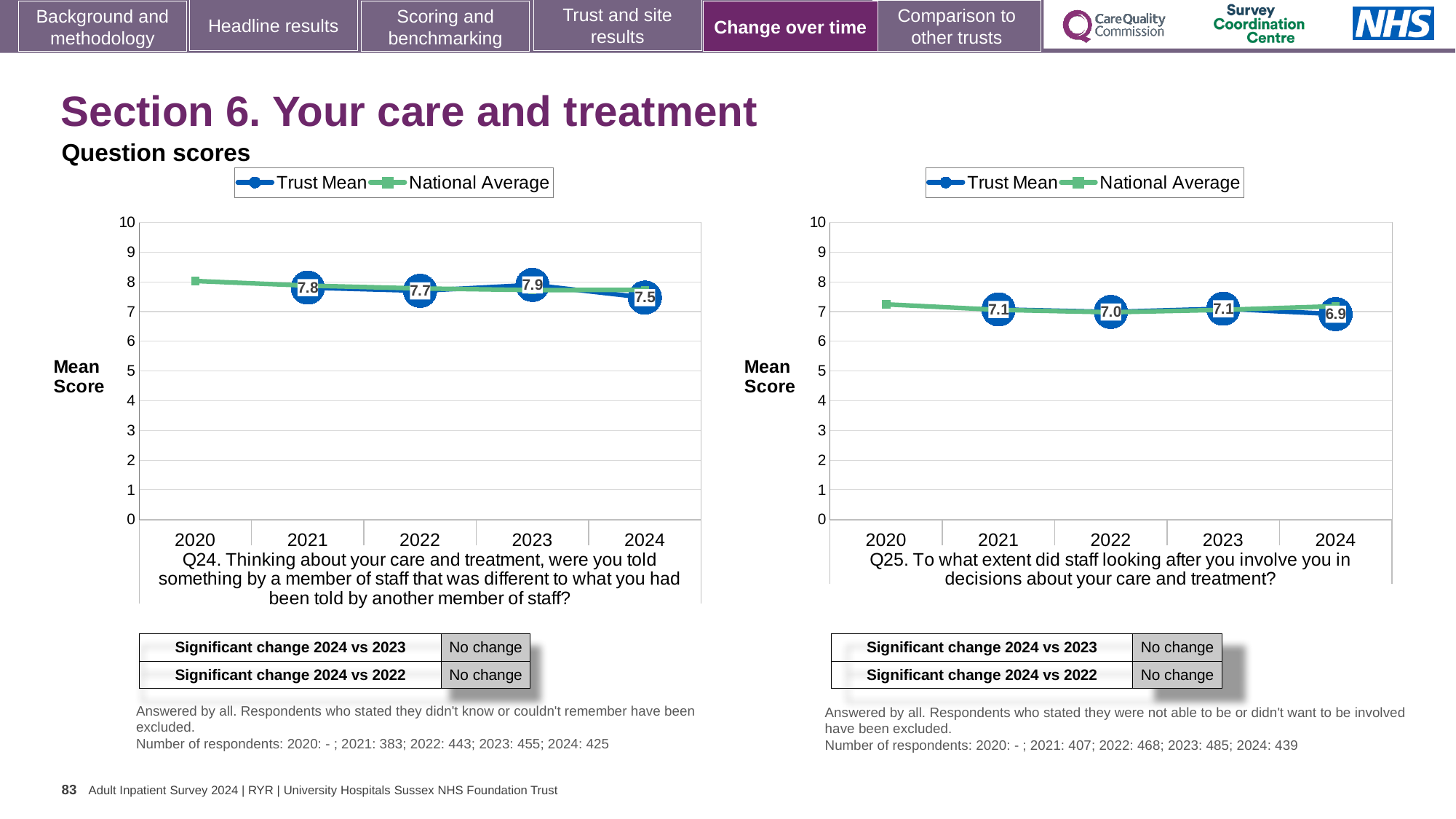
In the Q24 chart on the left, what is the Trust Mean score for 2024? 7.5 In the Q25 chart on the right, what is the Trust Mean score for 2022? 7.0 In the Q25 chart on the right, is the Trust Mean score for 2021 or 2024 higher? 2021 In the Q24 chart on the left, what is the Trust Mean score for 2023? 7.9 In the Q25 chart on the right, is the National Average for 2020 greater or less than 8? less How many series does the legend of the Q24 chart on the left list? 2 In the Q25 chart on the right, which year has the lowest Trust Mean score? 2024 In the Q24 chart on the left, which year has the lowest Trust Mean score? 2024 In the Q24 chart on the left, which year has the highest Trust Mean score? 2023 In the Q24 chart on the left, what is the difference between the Trust Mean scores for 2023 and 2024? 0.4 What type of chart is the Q25 chart on the right? Line chart In the Q25 chart on the right, what is the Trust Mean score for 2024? 6.9